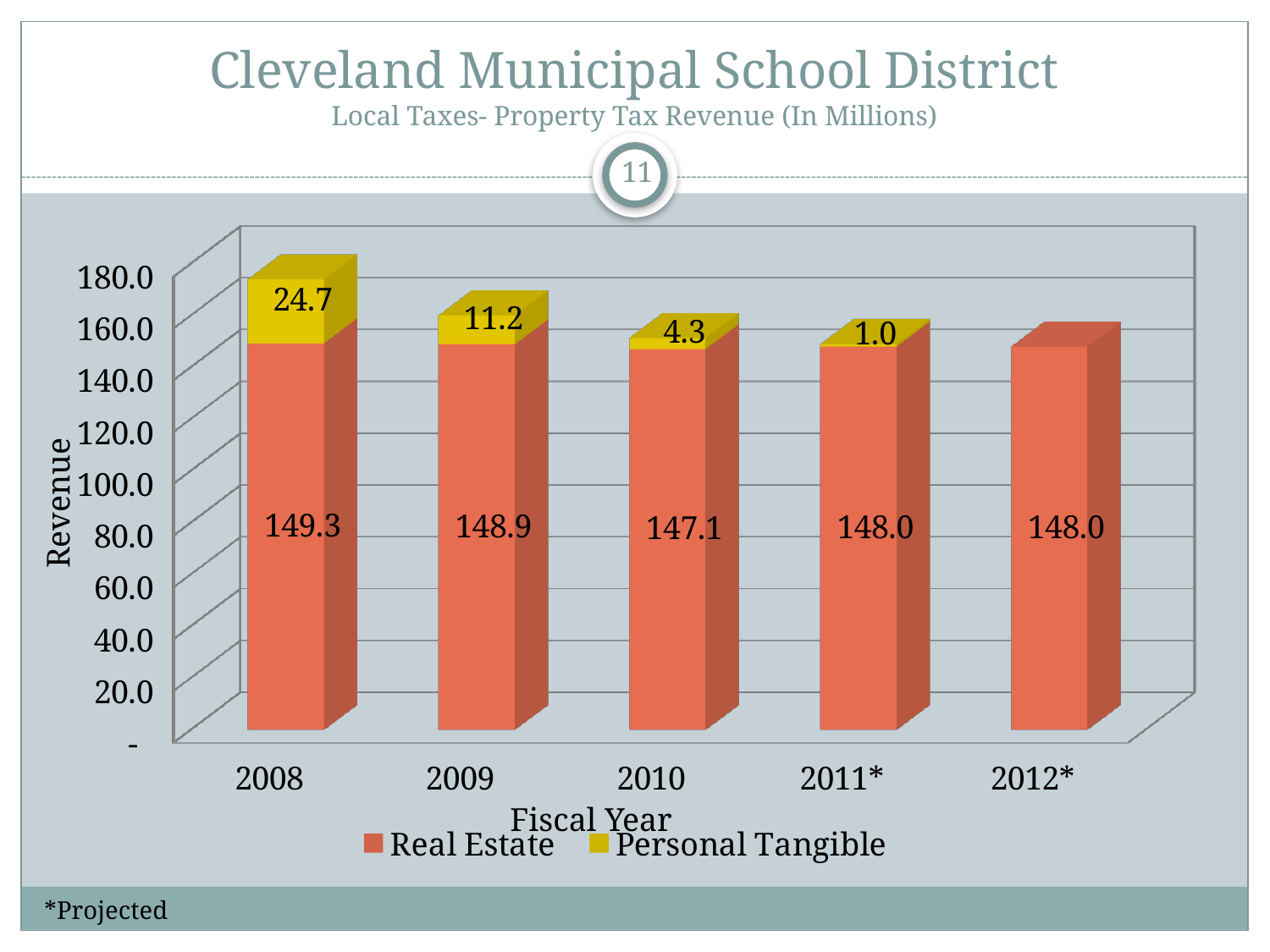
Do the Personal Tangible values rise or fall from 2008 to 2011*? Fall How many series does the legend list? 2 What is the Personal Tangible value for 2009? 11.2 What is the difference between the Personal Tangible values for 2008 and 2009? 13.5 What kind of chart is shown on the slide? Stacked bar chart What is the total of the stacked bar for 2010? 151.4 Which fiscal year has the lowest Real Estate value? 2010 How many fiscal years are shown on the x axis? 5 Which is larger, the Real Estate value for 2008 or for 2009? 2008 What is the Personal Tangible value for 2011*? 1.0 Which fiscal year has the highest Personal Tangible value? 2008 What is the Real Estate value for 2008? 149.3